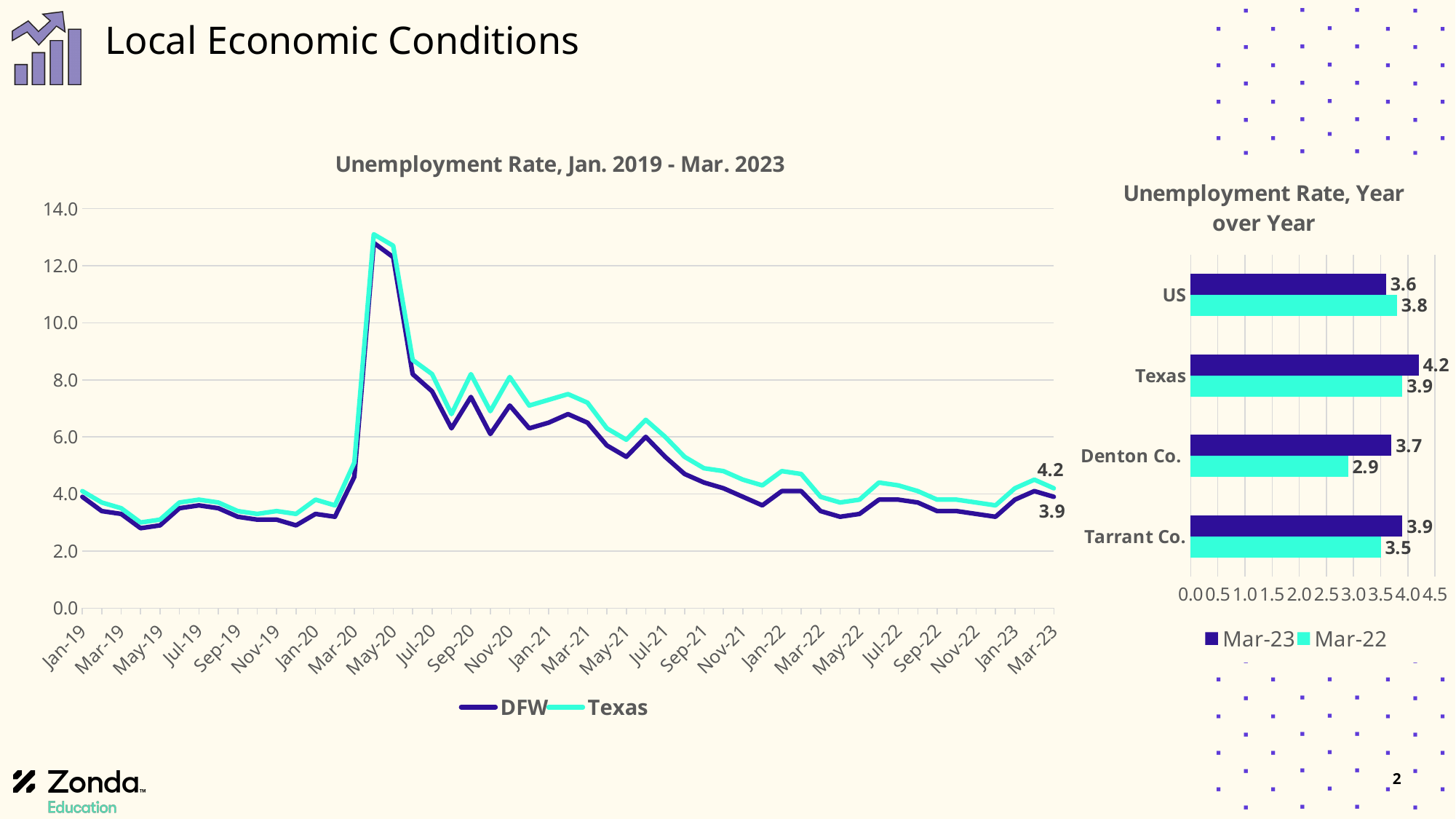
In the 'Unemployment Rate, Year over Year' chart, what is the Mar-23 value for Denton Co.? 3.7 In the 'Unemployment Rate, Jan. 2019 - Mar. 2023' chart, what is the Texas value at Mar-23? 4.2 In the 'Unemployment Rate, Year over Year' chart, how many series does the legend list? 2 In the 'Unemployment Rate, Year over Year' chart, what is the Mar-22 value for Tarrant Co.? 3.5 In the 'Unemployment Rate, Year over Year' chart, which category has the lowest Mar-22 value? Denton Co. In the 'Unemployment Rate, Year over Year' chart, what is the difference between the Mar-23 and Mar-22 values for Denton Co.? 0.8 What kind of chart is 'Unemployment Rate, Year over Year'? bar chart In the 'Unemployment Rate, Jan. 2019 - Mar. 2023' chart, is the Texas value at May-20 greater or less than 12.0? greater In the 'Unemployment Rate, Jan. 2019 - Mar. 2023' chart, what is the DFW value at Mar-23? 3.9 In the 'Unemployment Rate, Year over Year' chart, which category has the highest Mar-23 value? Texas In the 'Unemployment Rate, Year over Year' chart, is the US Mar-23 value larger or smaller than the US Mar-22 value? smaller In the 'Unemployment Rate, Year over Year' chart, how many categories are shown? 4